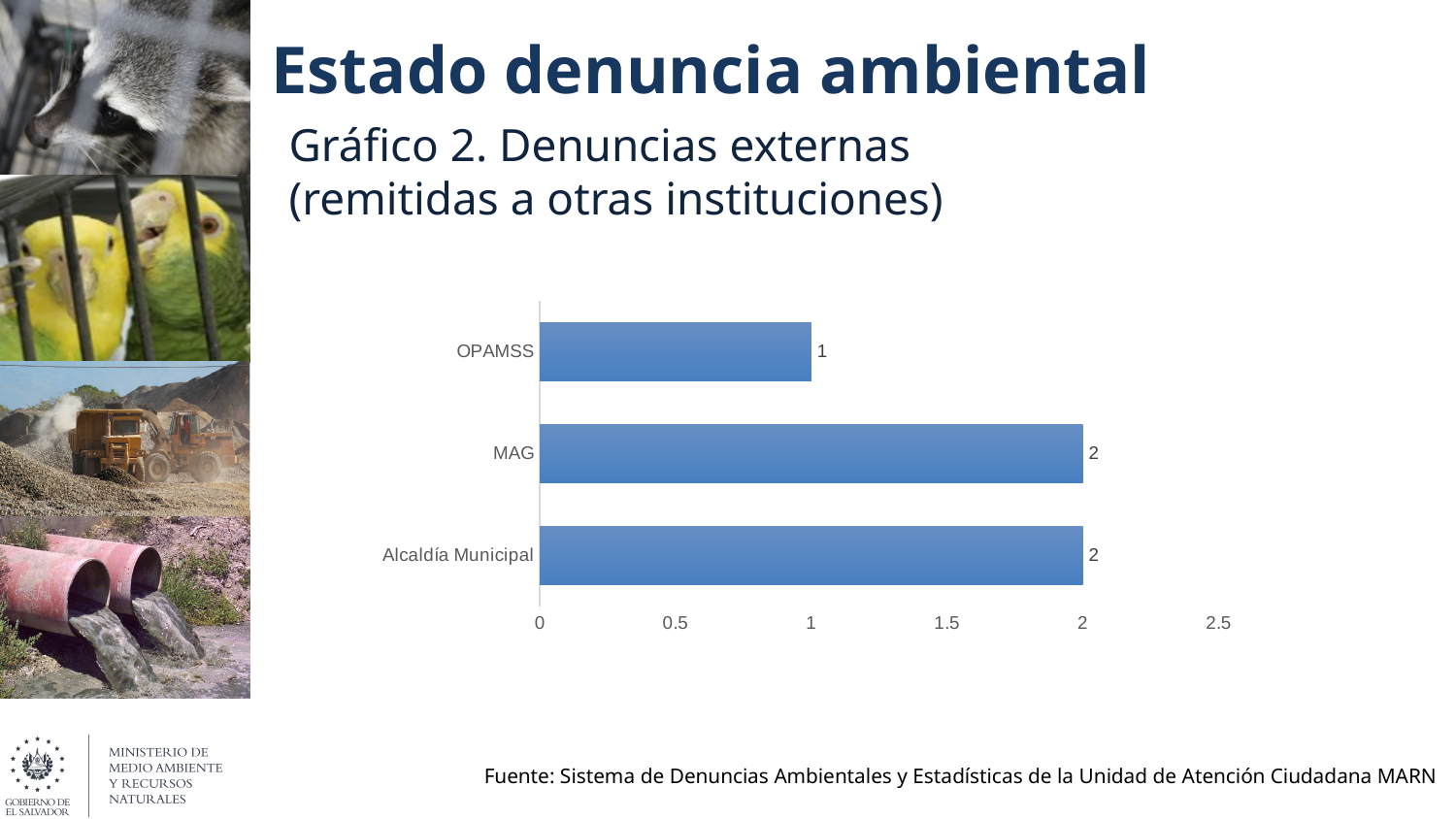
What is the difference between the values for MAG and OPAMSS? 1 What kind of chart is shown on the slide? Bar chart What is the value for OPAMSS? 1 What is the value for Alcaldía Municipal? 2 How many categories are shown in the chart? 3 What is the title of the chart? Gráfico 2. Denuncias externas (remitidas a otras instituciones) Which category has the lowest value? OPAMSS What is the value for MAG? 2 Which is larger, the value for Alcaldía Municipal or the value for OPAMSS? Alcaldía Municipal What is the total of all the values shown in the chart? 5 What is the highest value shown on the x axis? 2.5